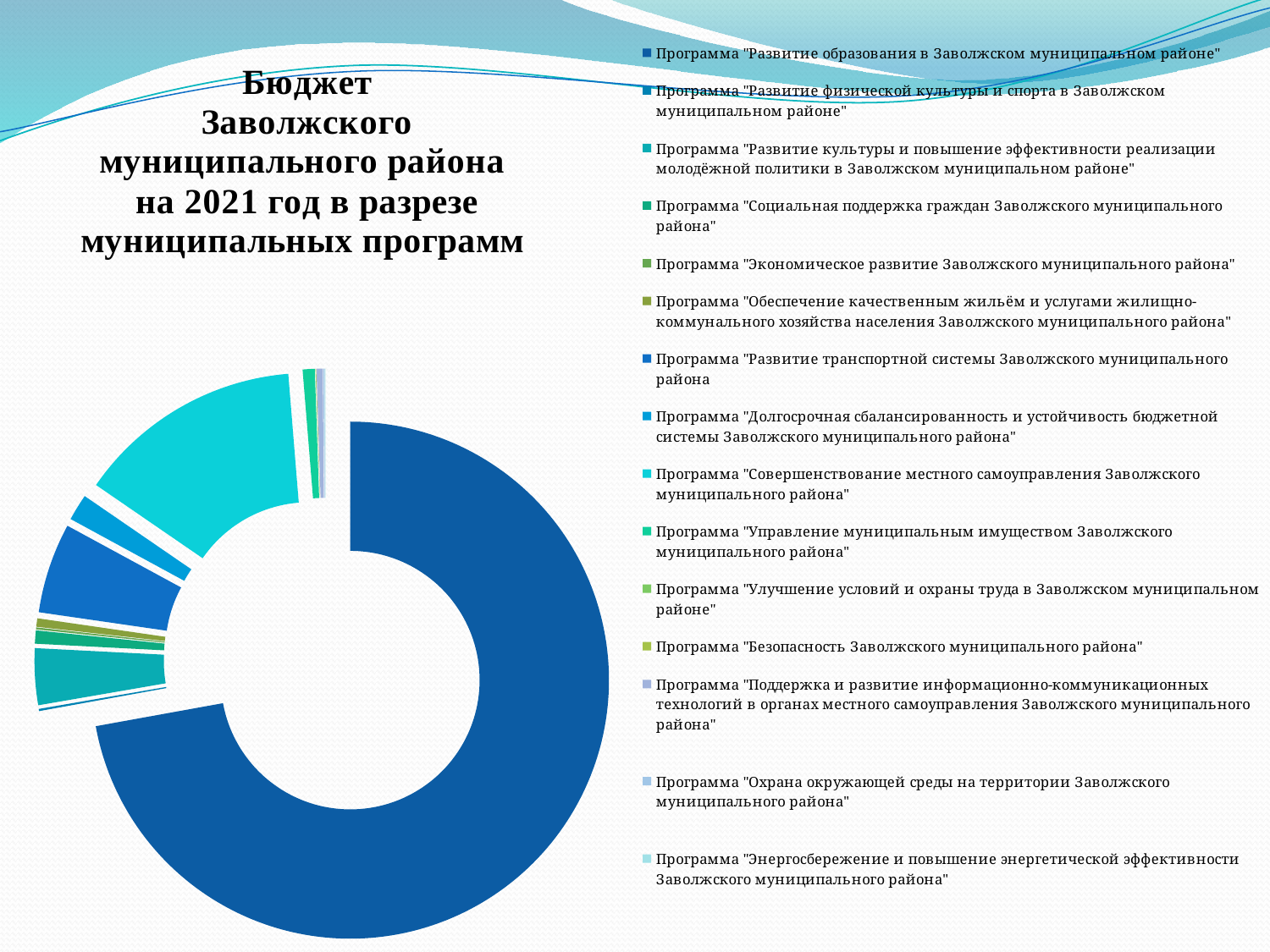
What is the title of the chart on the slide? Бюджет Заволжского муниципального района на 2021 год в разрезе муниципальных программ Which legend entry is listed first in the chart legend? Программа "Развитие образования в Заволжском муниципальном районе" Which program has the largest share of the 2021 budget in the chart? Программа "Развитие образования в Заволжском муниципальном районе" What kind of chart is shown on the slide? Doughnut (pie) chart Which is larger: the slice for "Развитие образования в Заволжском муниципальном районе" or the slice for "Безопасность Заволжского муниципального района"? Развитие образования в Заволжском муниципальном районе Which legend entry is listed last in the chart legend? Программа "Энергосбережение и повышение энергетической эффективности Заволжского муниципального района" How many municipal programs are listed in the chart legend? 15